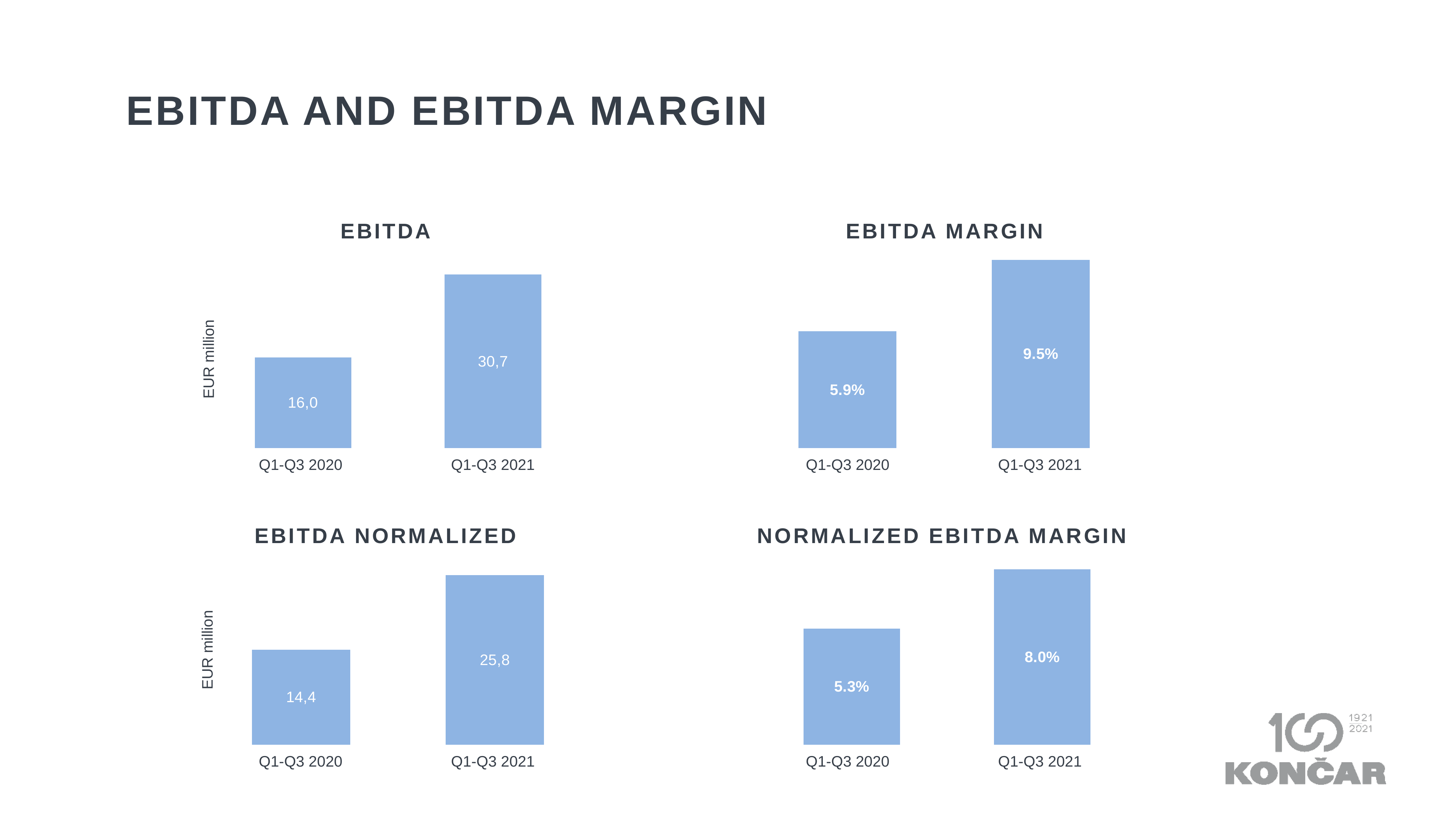
In the EBITDA MARGIN chart, what is the value for Q1-Q3 2021? 9.5% In the EBITDA chart, what is the value for Q1-Q3 2021? 30,7 In the NORMALIZED EBITDA MARGIN chart, which period has the higher value? Q1-Q3 2021 In the EBITDA MARGIN chart, what is the value for Q1-Q3 2020? 5.9% In the EBITDA chart, what is the difference between the Q1-Q3 2021 and Q1-Q3 2020 values? 14,6 In the EBITDA chart, what is the value for Q1-Q3 2020? 16,0 What type of chart is the EBITDA chart? Bar chart How many categories are shown in the EBITDA NORMALIZED chart? 2 In the NORMALIZED EBITDA MARGIN chart, what is the value for Q1-Q3 2020? 5.3% In the EBITDA NORMALIZED chart, what is the value for Q1-Q3 2021? 25,8 In the EBITDA MARGIN chart, which period has the lowest value? Q1-Q3 2020 In the EBITDA NORMALIZED chart, what is the difference between the Q1-Q3 2021 and Q1-Q3 2020 values? 11,4